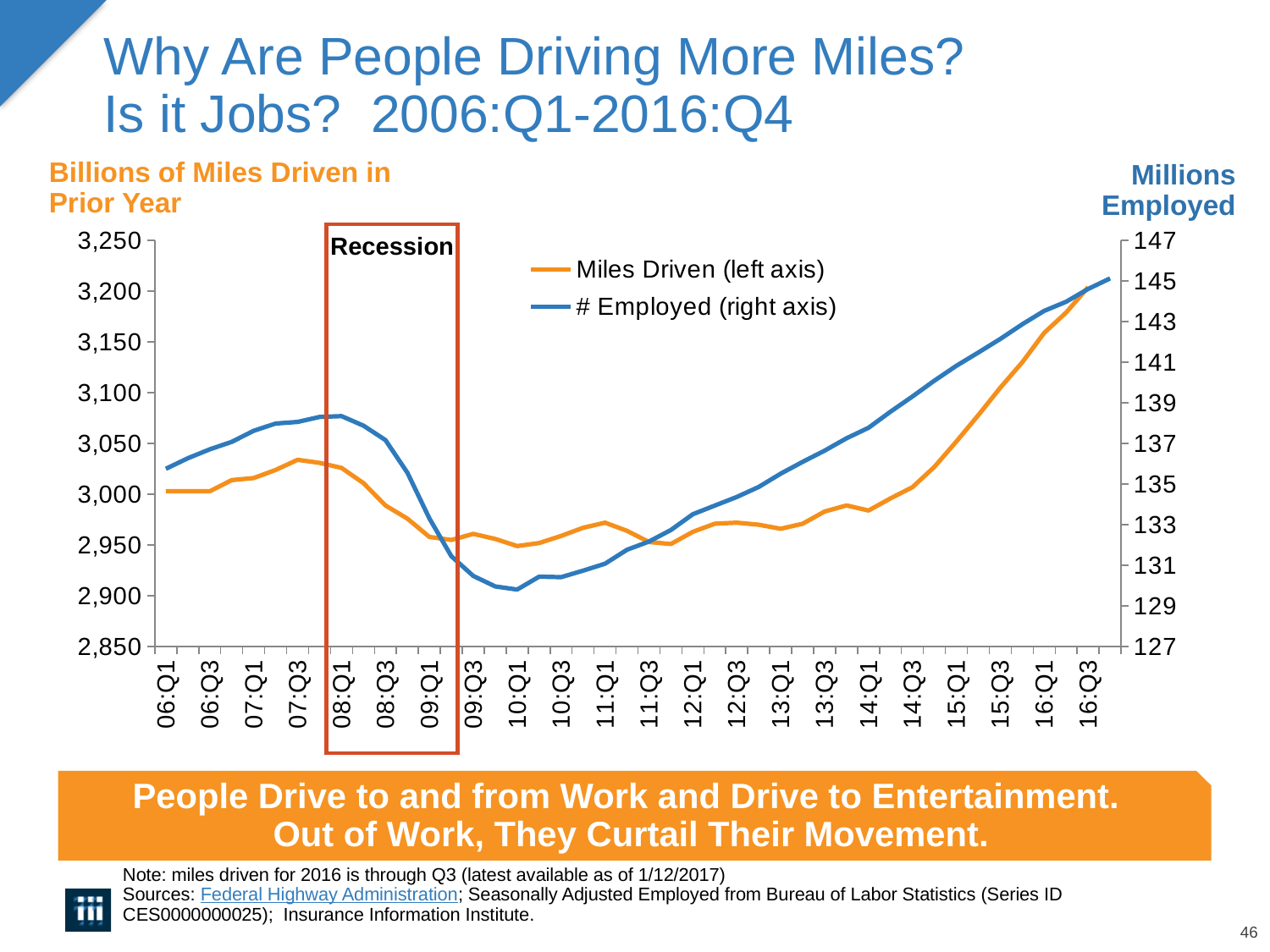
Is the Miles Driven value at 16:Q3 greater or less than 3,150? greater Does the # Employed series rise or fall between 08:Q1 and 09:Q3? fall Is the # Employed value at 16:Q3 greater or less than 143? greater Is the Miles Driven value at 10:Q1 greater or less than 3,000? less What is the title of the right-hand axis? Millions Employed What are the two series named in the legend? Miles Driven (left axis) and # Employed (right axis) At which quarter on the x axis does the Miles Driven series reach its highest value? 16:Q3 Does the Miles Driven series rise or fall between 14:Q3 and 16:Q3? rise What kind of chart is shown on the slide? line chart How many series does the chart's legend list? 2